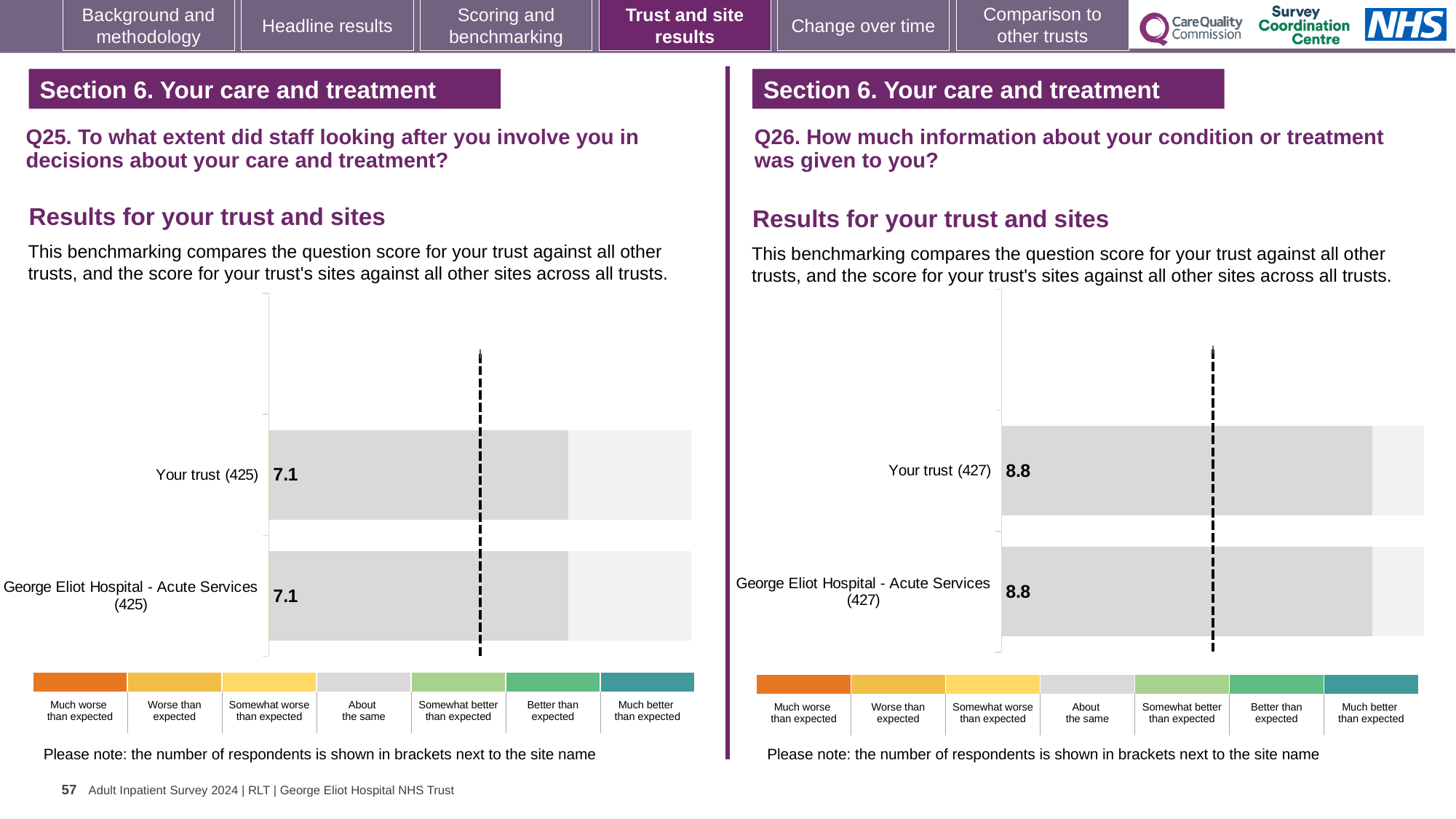
How many categories does the colour key below the Q26 chart on the right list? 7 In the Q25 chart on the left, what is the score for George Eliot Hospital - Acute Services? 7.1 How many bars are plotted in the Q26 chart on the right? 2 In the Q25 chart on the left, what is the difference between the score for Your trust and the score for George Eliot Hospital - Acute Services? 0 In the Q26 chart on the right, what is the score for George Eliot Hospital - Acute Services? 8.8 In the Q25 chart on the left, what is the score for Your trust? 7.1 In the Q26 chart on the right, how many respondents are shown in brackets next to George Eliot Hospital - Acute Services? 427 How many bars are plotted in the Q25 chart on the left? 2 In the Q25 chart on the left, how many respondents are shown in brackets next to Your trust? 425 In the Q26 chart on the right, what is the score for Your trust? 8.8 What kind of chart is used for the Q25 results on the left? Bar chart In the Q26 chart on the right, what is the difference between the score for Your trust and the score for George Eliot Hospital - Acute Services? 0